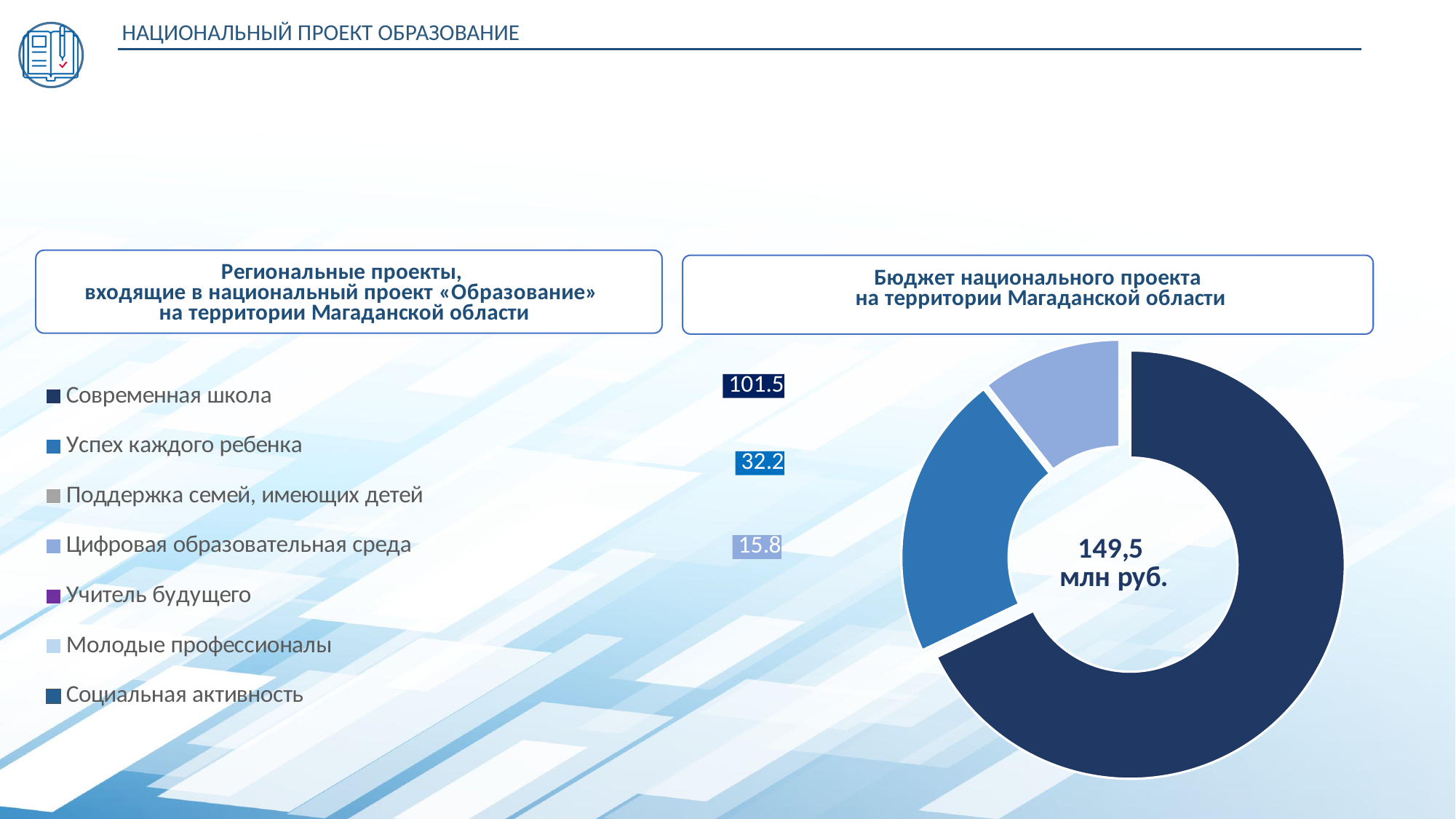
What is the difference between the values for Успех каждого ребенка and Цифровая образовательная среда? 16.4 Which is larger: the value for Успех каждого ребенка or for Цифровая образовательная среда? Успех каждого ребенка What is the difference between the values for Современная школа and Успех каждого ребенка? 69.3 What is the title of the box above the doughnut chart? Бюджет национального проекта на территории Магаданской области What is the value shown for Современная школа? 101.5 What is the value shown for Цифровая образовательная среда? 15.8 Which category has the largest slice in the doughnut chart? Современная школа What is the value shown for Успех каждого ребенка? 32.2 What type of chart is shown on the slide? Doughnut chart Which of the labelled slices has the smallest value? Цифровая образовательная среда How many entries does the legend list? 7 What total is printed in the centre of the doughnut chart? 149,5 млн руб.